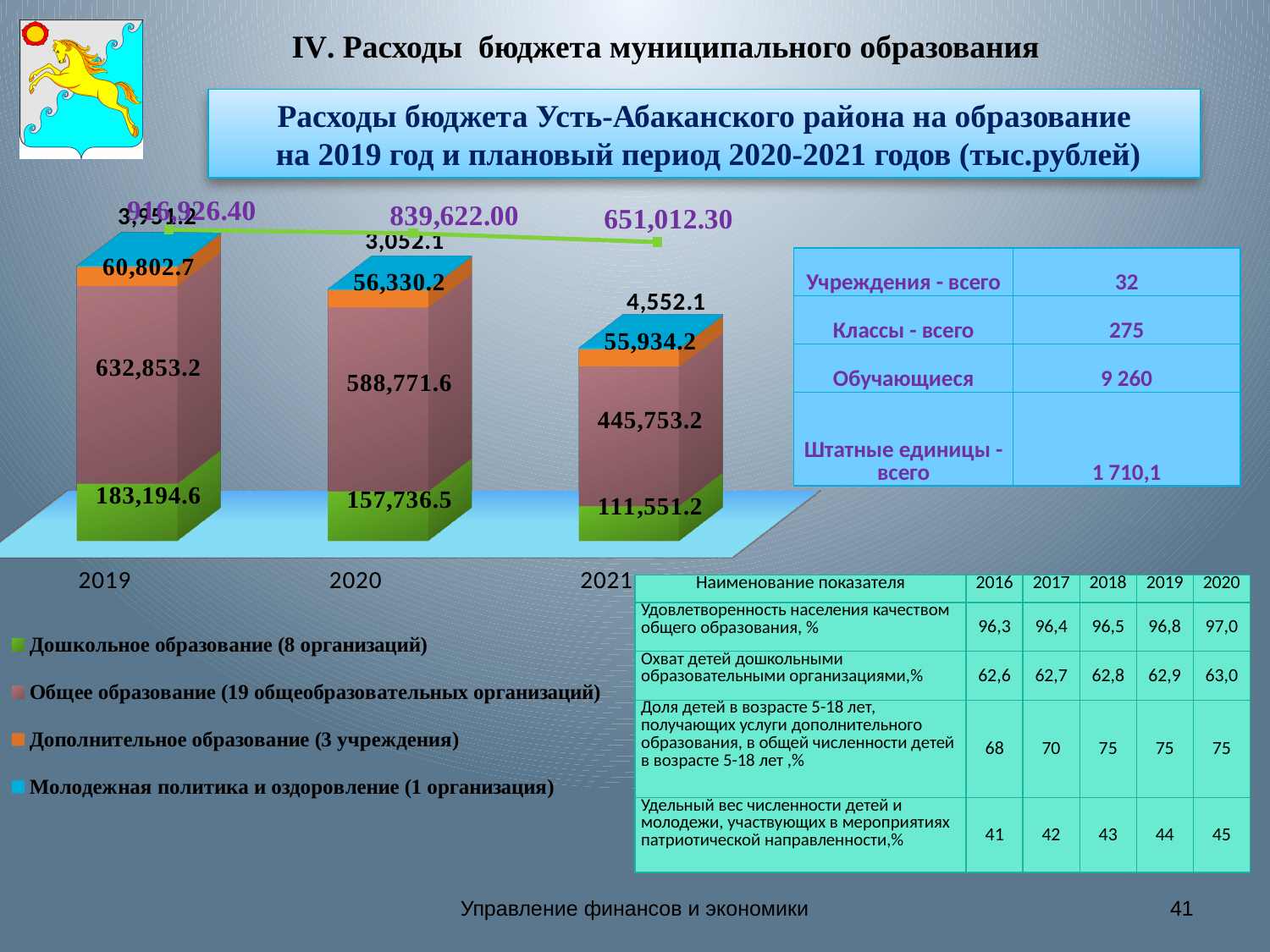
Which year has the highest value for Общее образование? 2019 Is the value for Общее образование larger in 2020 or in 2021? 2020 Which year has the lowest value for Дошкольное образование? 2021 What is the total shown above the bar for 2020? 839,622.00 What is the value for Молодежная политика и оздоровление in 2021? 4,552.1 What is the value for Дошкольное образование in 2021? 111,551.2 What is the value for Общее образование in 2019? 632,853.2 How many series does the chart legend list? 4 What is the value for Дополнительное образование in 2020? 56,330.2 How many years are shown on the x axis of the chart? 3 Do the total values shown above the bars rise or fall from 2019 to 2021? fall What is the difference between the Дошкольное образование values for 2019 and 2020? 25,458.1